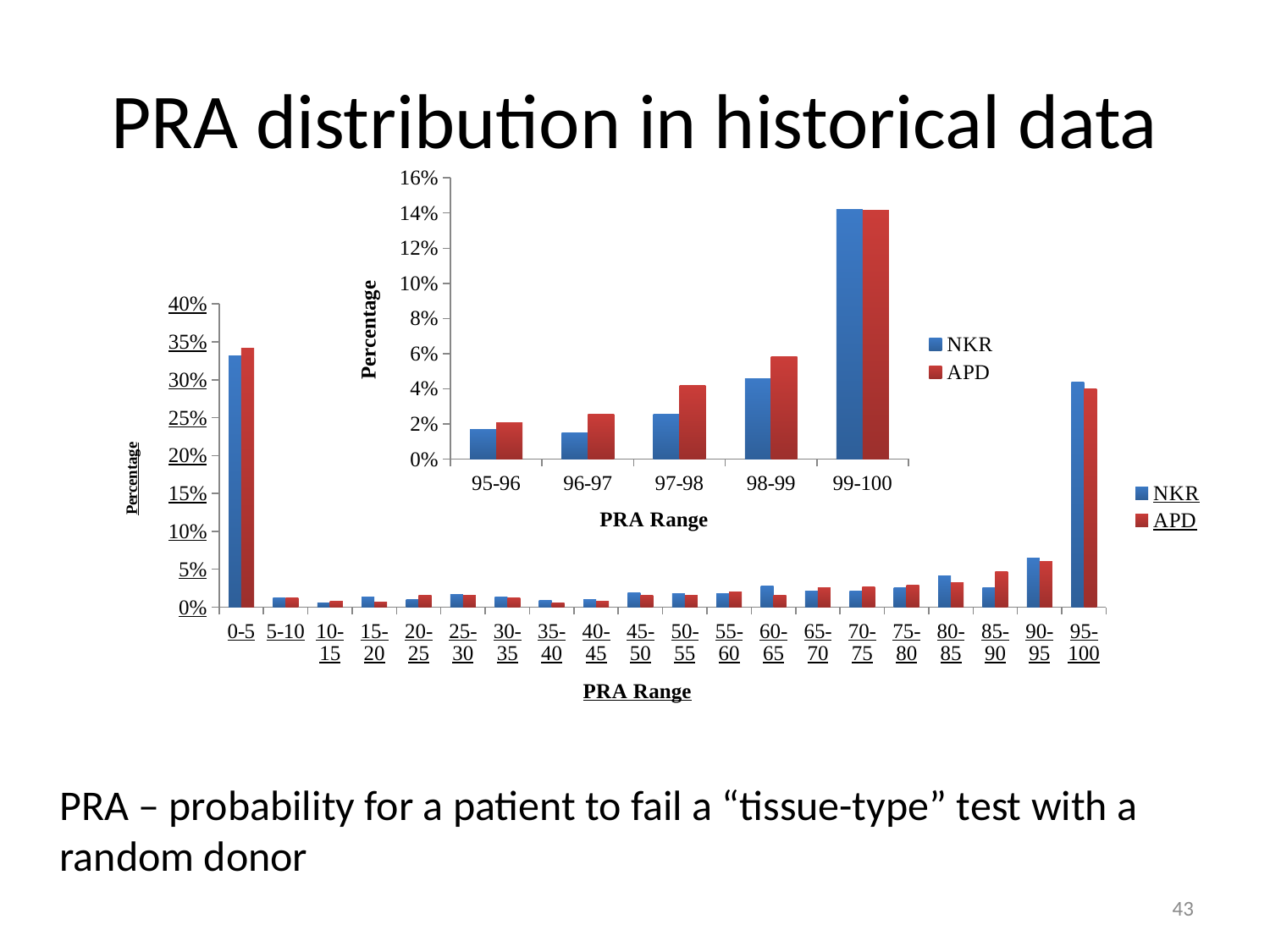
In the large chart, is the NKR value for 95-100 greater or less than 5%? greater How many PRA range categories are shown on the x axis of the inset chart? 5 How many series does the legend of the large chart list? 2 In the inset chart, which is larger for 98-99, NKR or APD? APD How many PRA range categories are shown on the x axis of the large chart? 20 In the large chart, which PRA range has the highest NKR value? 0-5 In the inset chart, which PRA range has the highest APD value? 99-100 In the large chart, which is larger for 85-90, NKR or APD? APD In the large chart, is the NKR value for 0-5 greater or less than 30%? greater What type of chart is the large chart on the slide? bar chart In the inset chart, is the NKR value for 99-100 greater or less than 12%? greater What are the two series named in the legend of the inset chart? NKR and APD